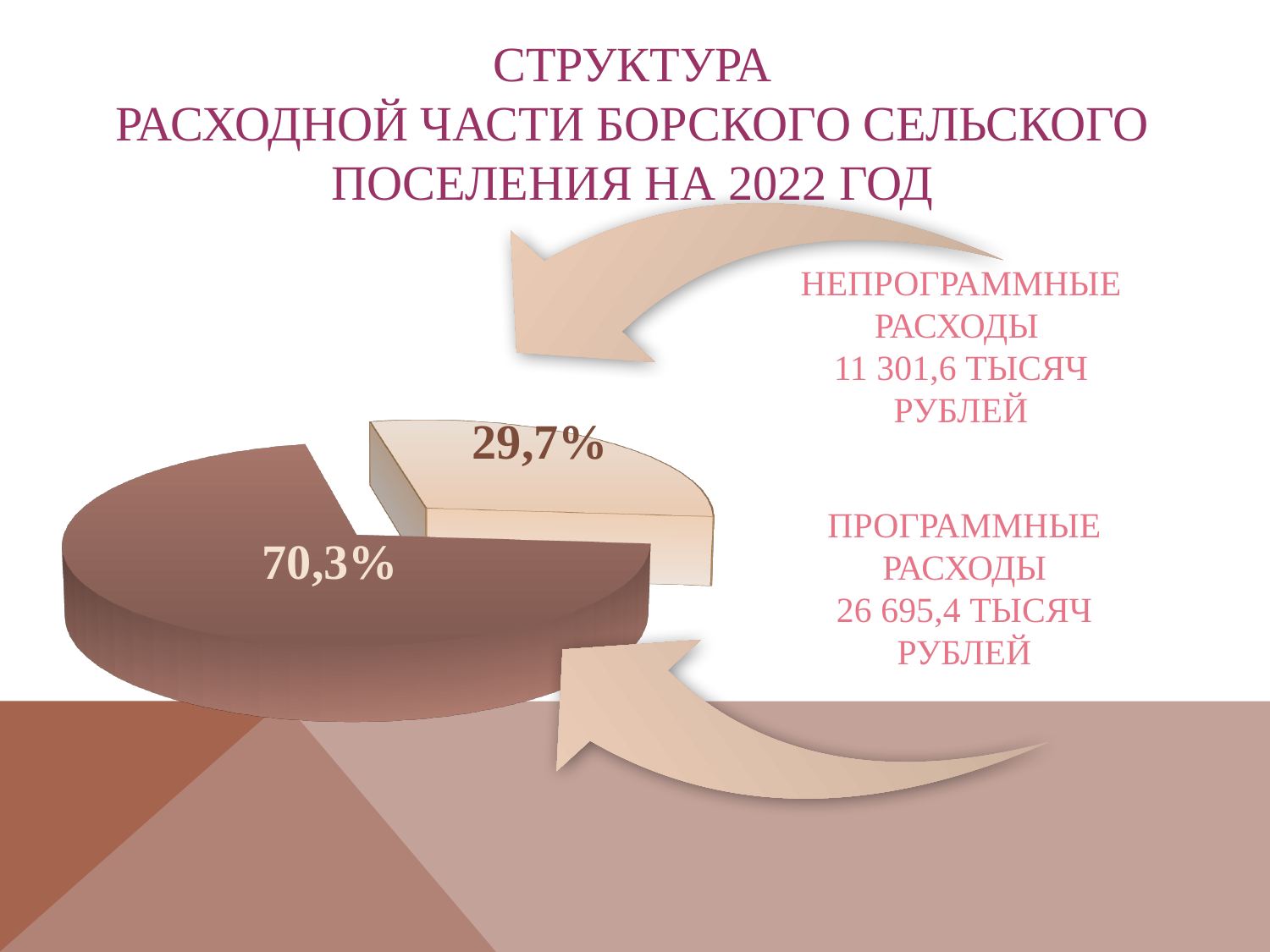
How many slices does the pie chart have? 2 For which year does the chart show the expenditure structure of Борское сельское поселение? 2022 What amount in thousand rubles is given for ПРОГРАММНЫЕ РАСХОДЫ? 26 695,4 What amount in thousand rubles is given for НЕПРОГРАММНЫЕ РАСХОДЫ? 11 301,6 Which category has the larger share of the pie, ПРОГРАММНЫЕ РАСХОДЫ or НЕПРОГРАММНЫЕ РАСХОДЫ? ПРОГРАММНЫЕ РАСХОДЫ What share of the pie is labelled for the larger slice? 70,3% Which category has the smallest share of the pie? НЕПРОГРАММНЫЕ РАСХОДЫ What kind of chart is shown on the slide? pie chart What share of the pie is labelled for the smaller slice? 29,7% What is the difference in percentage points between the two slices of the pie? 40,6 What percentage corresponds to НЕПРОГРАММНЫЕ РАСХОДЫ? 29,7% What percentage corresponds to ПРОГРАММНЫЕ РАСХОДЫ? 70,3%